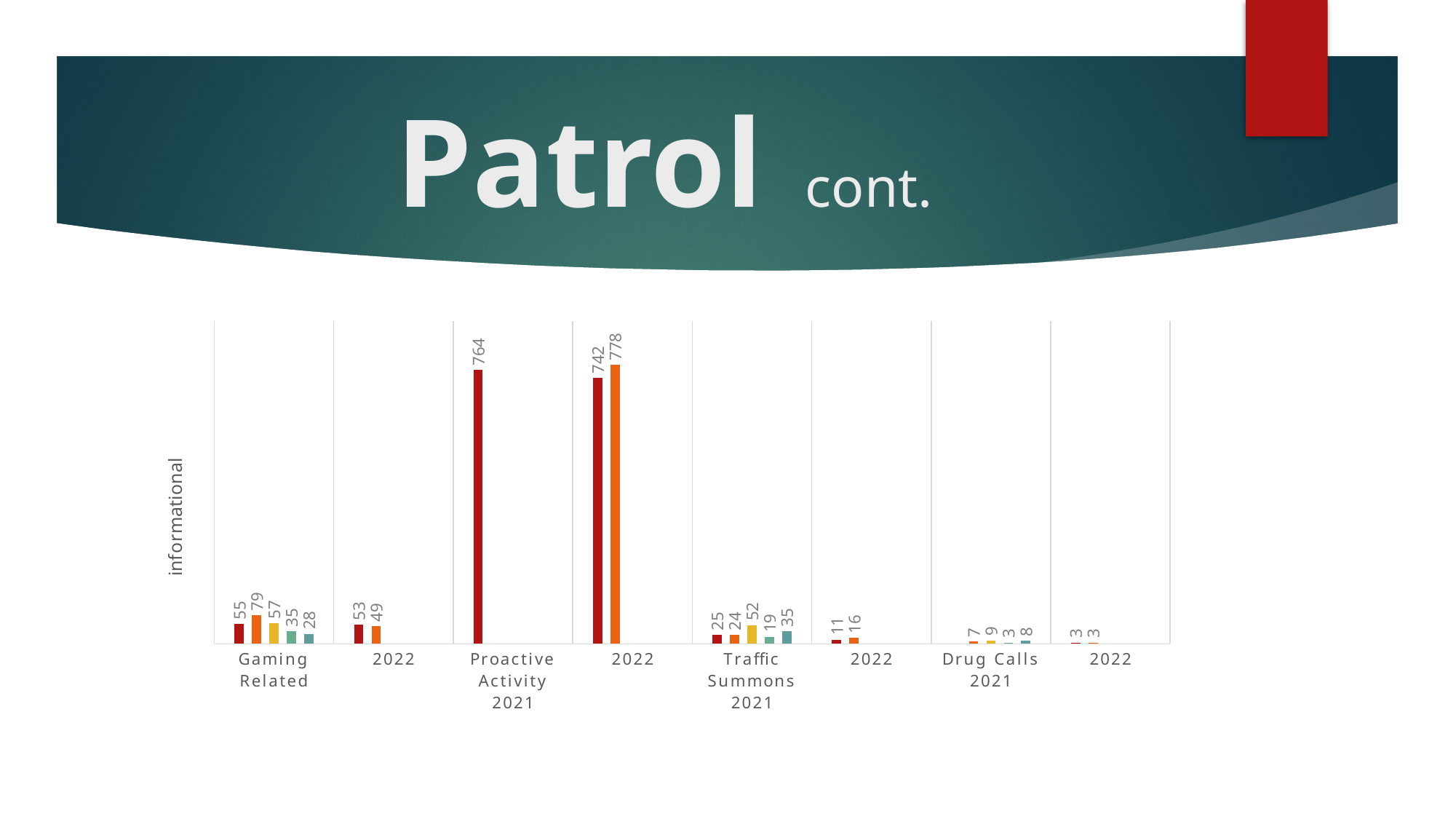
What is the value of the yellow (third) bar in the Traffic Summons 2021 category? 52 What is the value of the single bar in the Proactive Activity 2021 category? 764 What is the difference between the orange bar (778) and the dark red bar (742) in the 2022 category following Proactive Activity 2021? 36 What are the values of the two bars in the 2022 category next to Drug Calls 2021? 3 and 3 Which is larger in the Traffic Summons 2021 category: the dark red (first) bar or the teal (last) bar? the teal (last) bar, 35 What is the value of the orange (second) bar in the 2022 category next to Proactive Activity 2021? 778 What is the value of the dark red (first) bar in the Gaming Related category? 55 How many categories are shown along the x axis of the chart? 8 What type of chart is shown on the slide? bar chart What is the label on the vertical axis of the chart? informational What is the difference between the dark red bar (53) and the orange bar (49) in the 2022 category next to Gaming Related? 4 Which bar in the Gaming Related category has the highest value? the orange (second) bar, 79